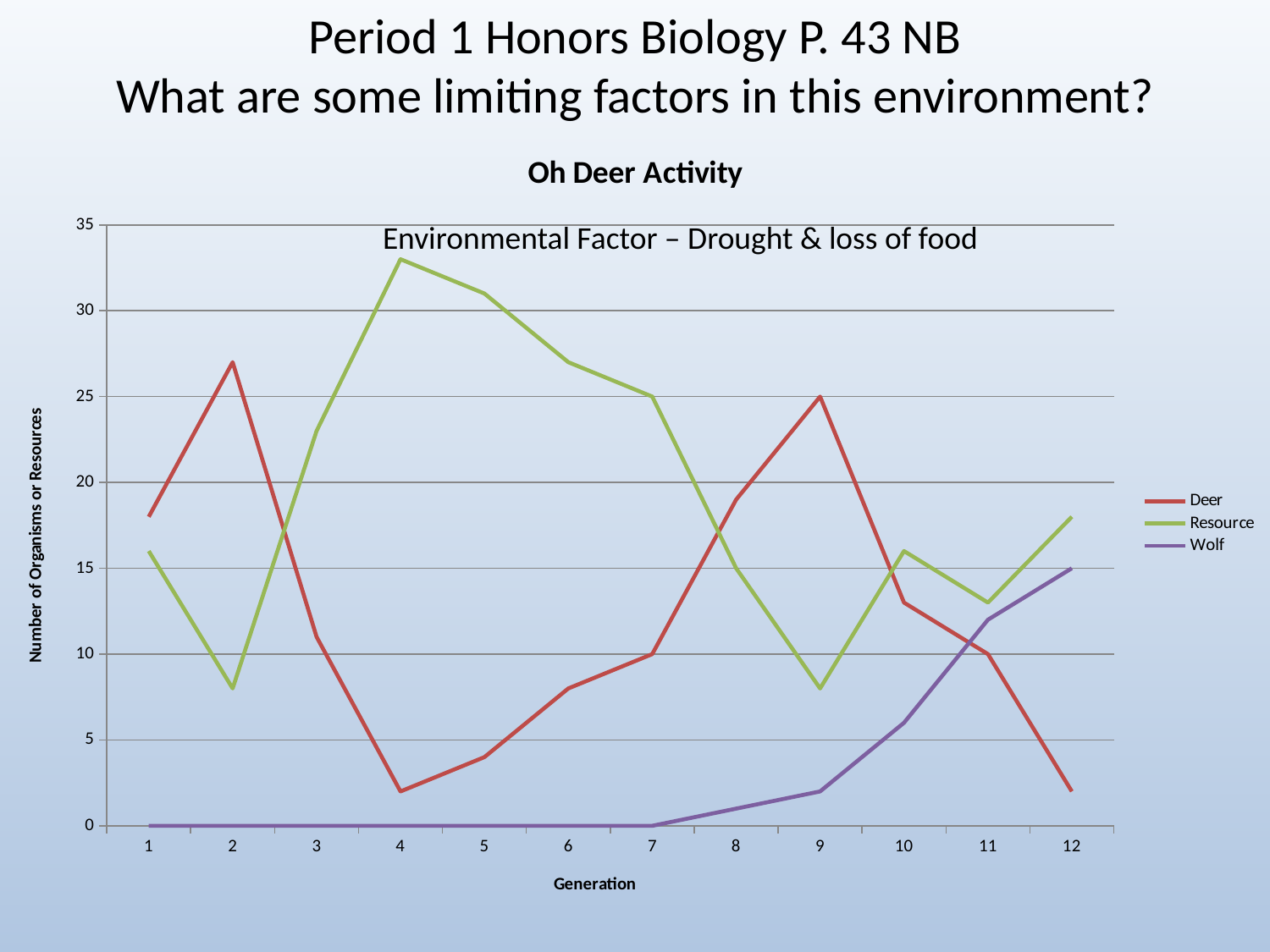
Is the Resource value at generation 4 greater or less than 30? greater Is the Deer value at generation 4 greater or less than 5? less What is the Wolf value at generation 12? 15 What is the title of the chart? Oh Deer Activity What is the Deer value at generation 9? 25 Does the Wolf series rise or fall from generation 7 to generation 12? rise How many generations are plotted along the x axis? 12 What kind of chart is shown on the slide? line chart How many series does the legend list? 3 What is the Wolf value at generation 1? 0 At generation 2, which is larger, Deer or Resource? Deer At which generation does the Resource series reach its highest value? 4